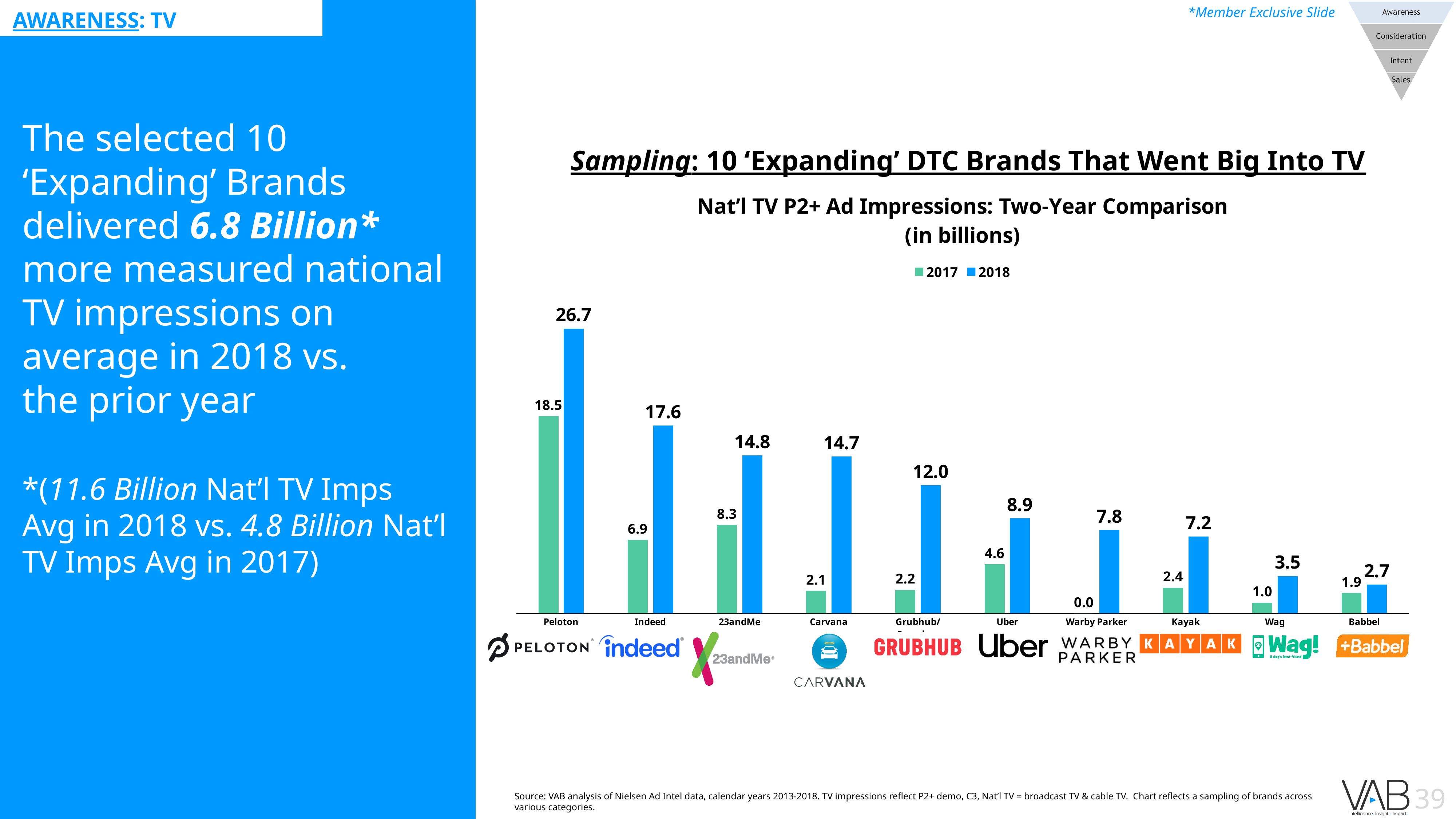
What is the subtitle of the chart describing the measure plotted? Nat'l TV P2+ Ad Impressions: Two-Year Comparison (in billions) Which brand has the highest 2018 value? Peloton How many brands are shown on the x axis of the chart? 10 Which is larger, the 2018 value for Uber or the 2018 value for Kayak? Uber How many series does the legend list? 2 What is the 2017 value for Warby Parker? 0.0 Which brand has the lowest 2018 value? Babbel What is the 2017 value for Carvana? 2.1 What kind of chart is shown on the slide? bar chart What is the 2018 value for Peloton? 26.7 Is the 2018 value for Grubhub greater or less than the 2018 value for Carvana? less What is the difference between the 2018 and 2017 values for Indeed? 10.7